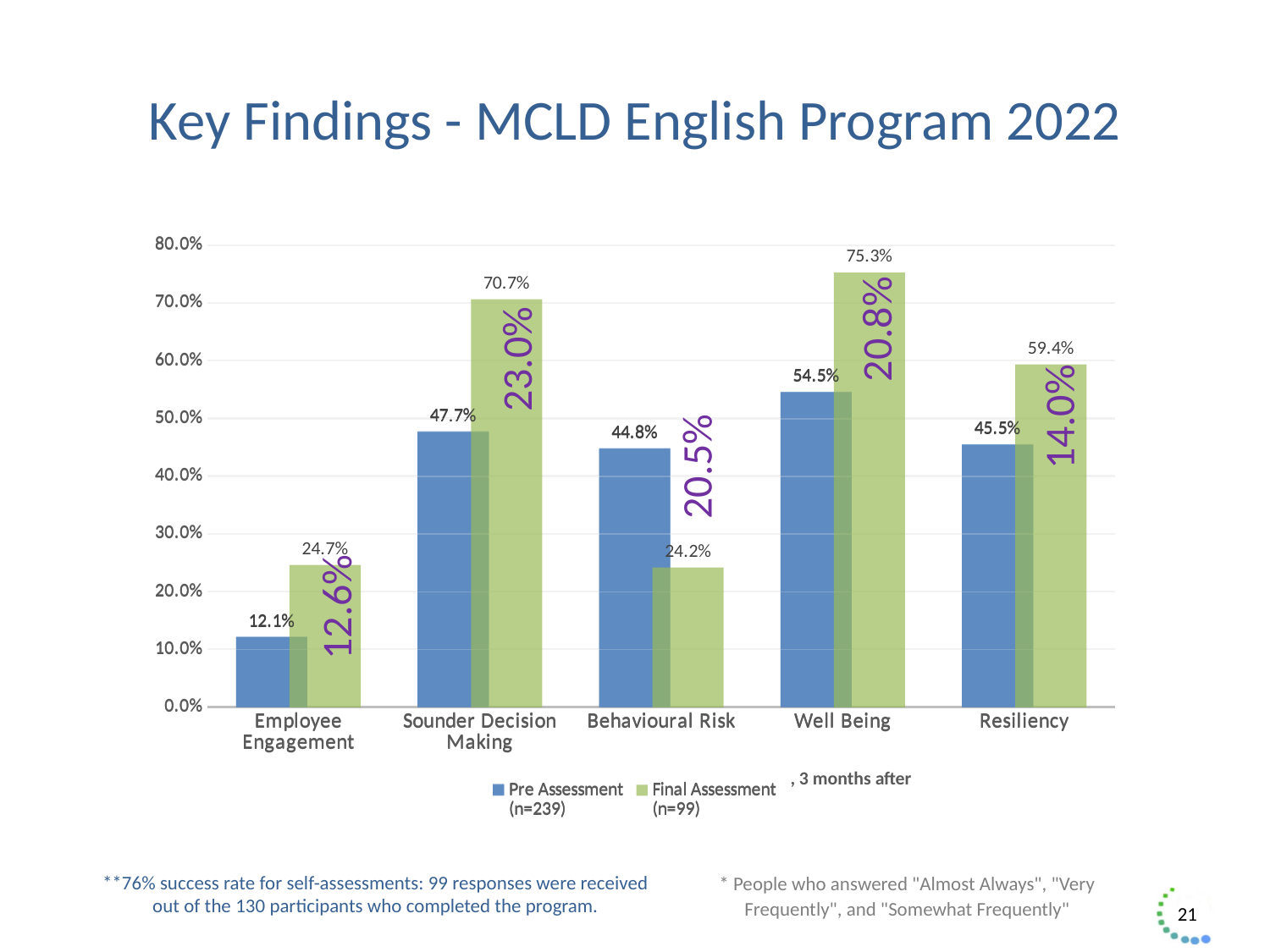
What is the Pre Assessment value for Employee Engagement? 12.1% Which category has the highest Final Assessment value? Well Being What is the Pre Assessment value for Resiliency? 45.5% What is the Final Assessment value for Well Being? 75.3% What is the Final Assessment value for Behavioural Risk? 24.2% How many series does the legend list? 2 How many categories are shown on the x axis? 5 Which category has the lowest Pre Assessment value? Employee Engagement What is the sample size (n) shown in the legend for the Final Assessment series? n=99 What is the difference between the Final Assessment and Pre Assessment values for Sounder Decision Making? 23.0% Which is larger for Behavioural Risk, the Pre Assessment value or the Final Assessment value? Pre Assessment What kind of chart is shown on the slide? Bar chart